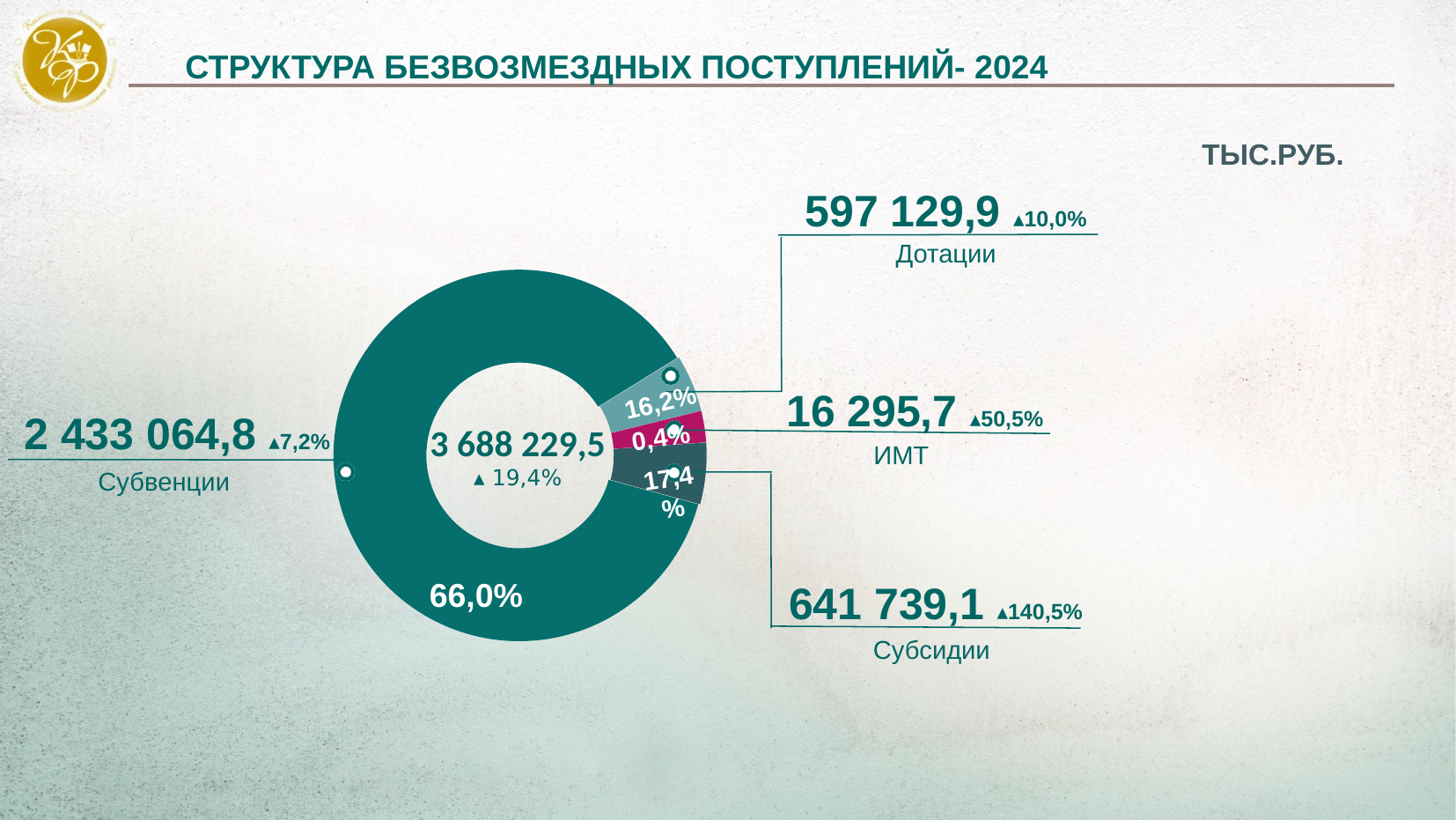
What is the value for Дотации? 597 129,9 Which is larger, the value for Субсидии or the value for Дотации? Субсидии Which category has the largest share of the donut? Субвенции What share of the donut does Субсидии take? 17,4% How many categories are shown in the donut chart? 4 What is the value for Субвенции? 2 433 064,8 What share of the donut does Субвенции take? 66,0% What is the value for ИМТ? 16 295,7 What is the value for Субсидии? 641 739,1 Which category has the smallest share of the donut? ИМТ What kind of chart is shown on the slide? Donut (pie) chart What total value is shown in the centre of the donut? 3 688 229,5